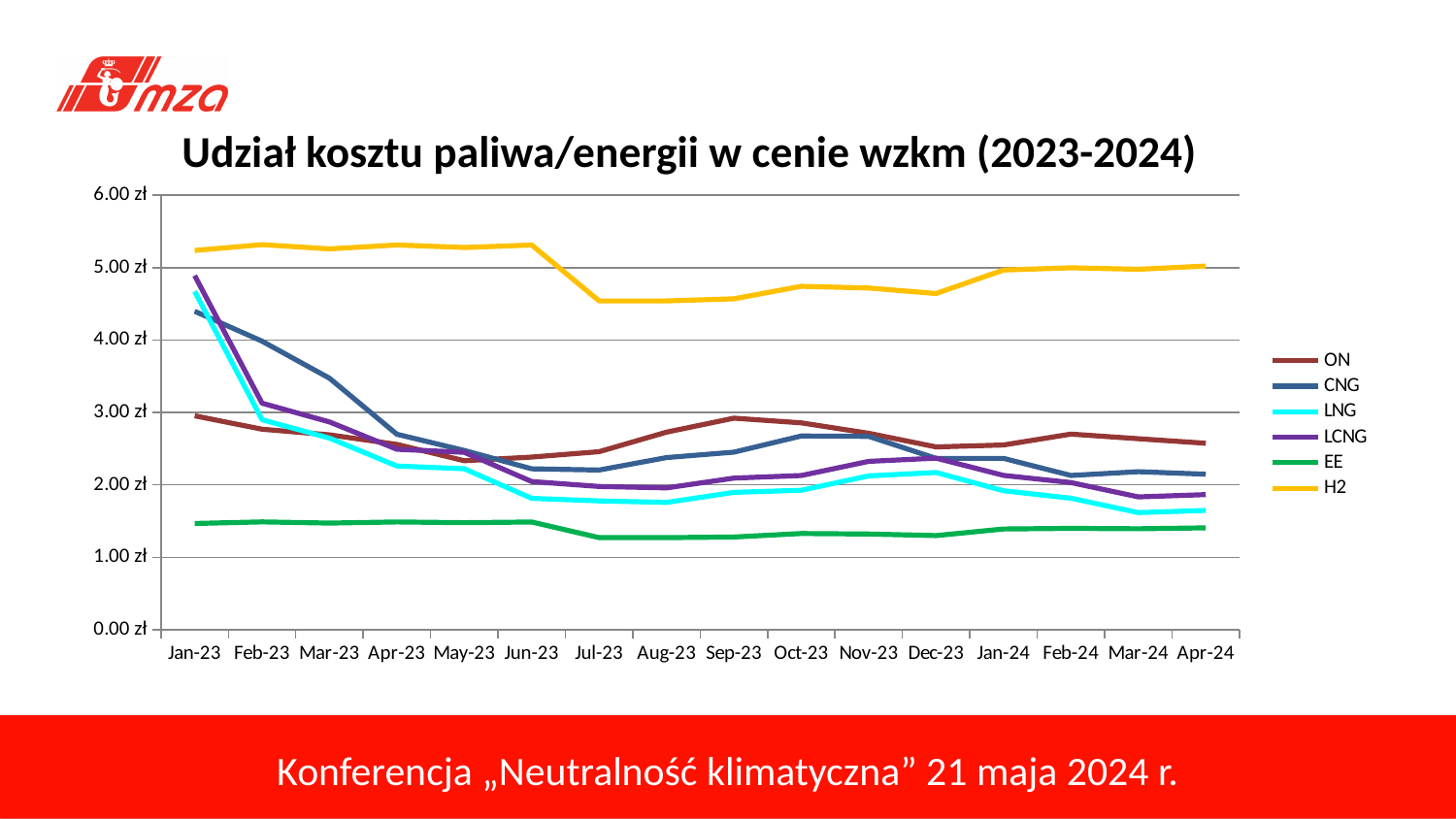
How many months are plotted along the x axis? 16 Is the value for LNG in Apr-24 greater or less than 2.00 zł? less What is the title of the chart? Udział kosztu paliwa/energii w cenie wzkm (2023-2024) Is the value for H2 in Jan-23 greater or less than 5.00 zł? greater Which series has the lowest values across the whole period? EE What kind of chart is shown on the slide? line chart Is the value for CNG in Jan-23 greater or less than 4.00 zł? greater Does the CNG line rise or fall from Jan-23 to Apr-24? fall Which series has the highest values across the whole period? H2 How many series does the legend list? 6 In Jan-23, which is larger: the value for CNG or the value for ON? CNG